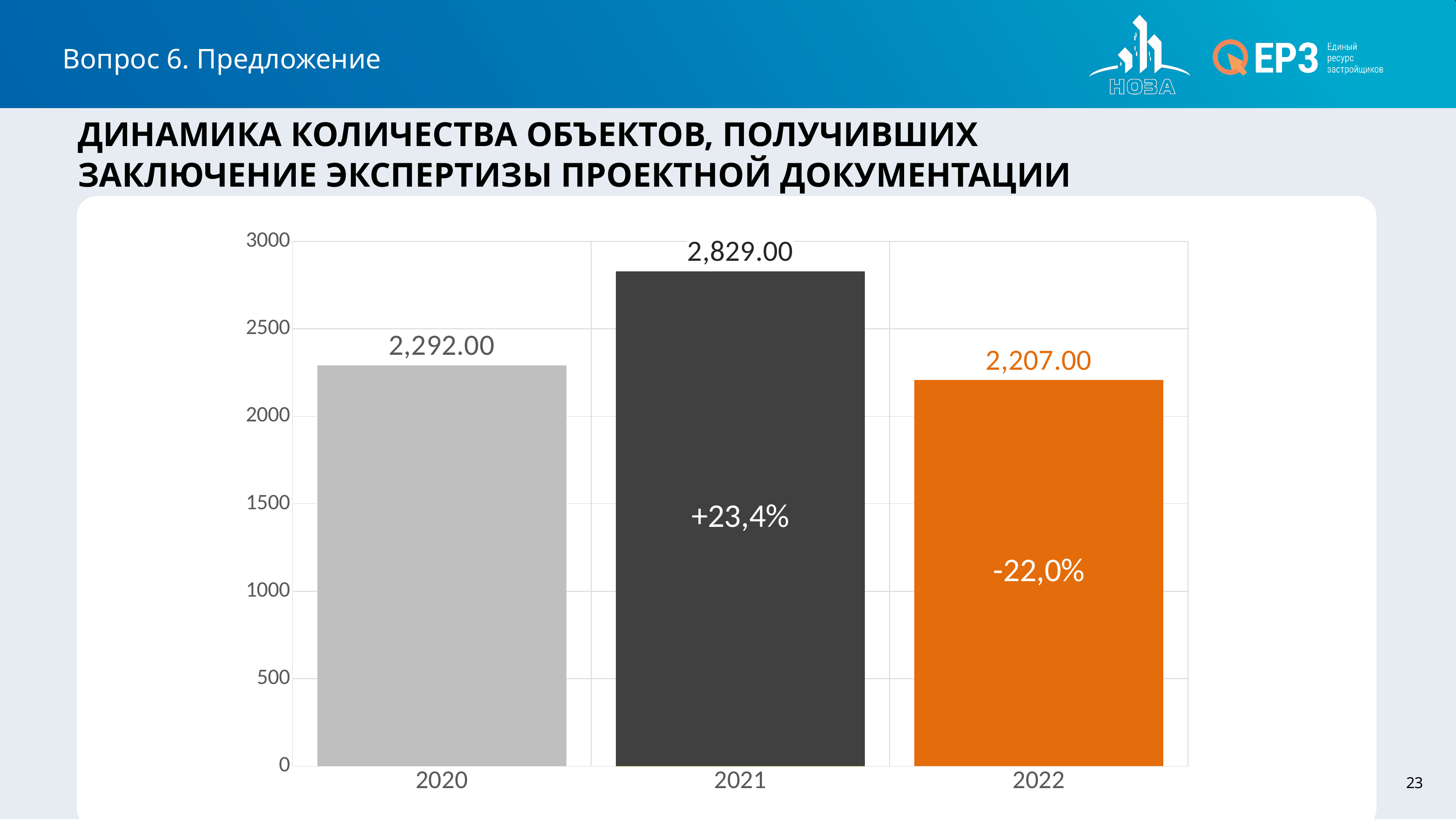
Which year has the lowest value? 2022 Which year has the highest value? 2021 What is the difference between the values for 2021 and 2022? 622.00 Which is larger, the value for 2020 or the value for 2022? 2020 How many years are shown on the x axis? 3 What is the value for 2021? 2,829.00 What is the difference between the values for 2021 and 2020? 537.00 Is the value for 2021 greater or less than 2500? greater What percentage change is printed inside the bar for 2022? -22,0% What is the value for 2022? 2,207.00 What is the value for 2020? 2,292.00 What kind of chart is shown on the slide? bar chart